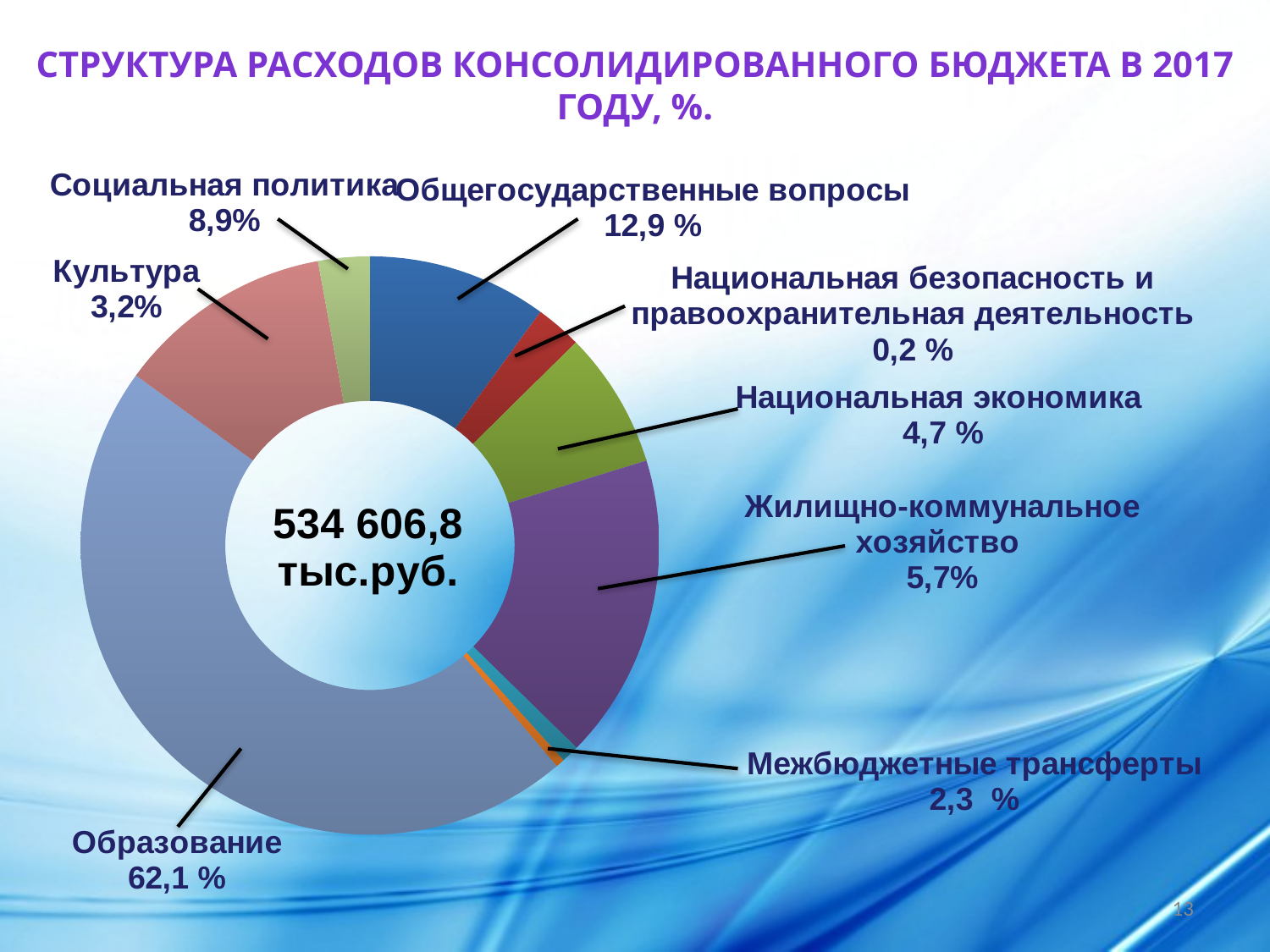
Which category has the largest share of the budget expenditures? Образование What total amount is printed in the centre of the chart? 534 606,8 тыс.руб. Which is larger, the share for Национальная экономика or for Жилищно-коммунальное хозяйство? Жилищно-коммунальное хозяйство What percentage is labelled for Жилищно-коммунальное хозяйство? 5,7% What share is shown for Межбюджетные трансферты? 2,3 % What year does the chart title refer to? 2017 What is the difference in percentage points between Социальная политика and Культура? 5,7 What is the value for Национальная безопасность и правоохранительная деятельность? 0,2 % Which labelled category has the smallest share? Национальная безопасность и правоохранительная деятельность What is the value shown for Общегосударственные вопросы? 12,9 % What kind of chart is shown on the slide? Doughnut (pie) chart What share of expenditures goes to Образование? 62,1 %